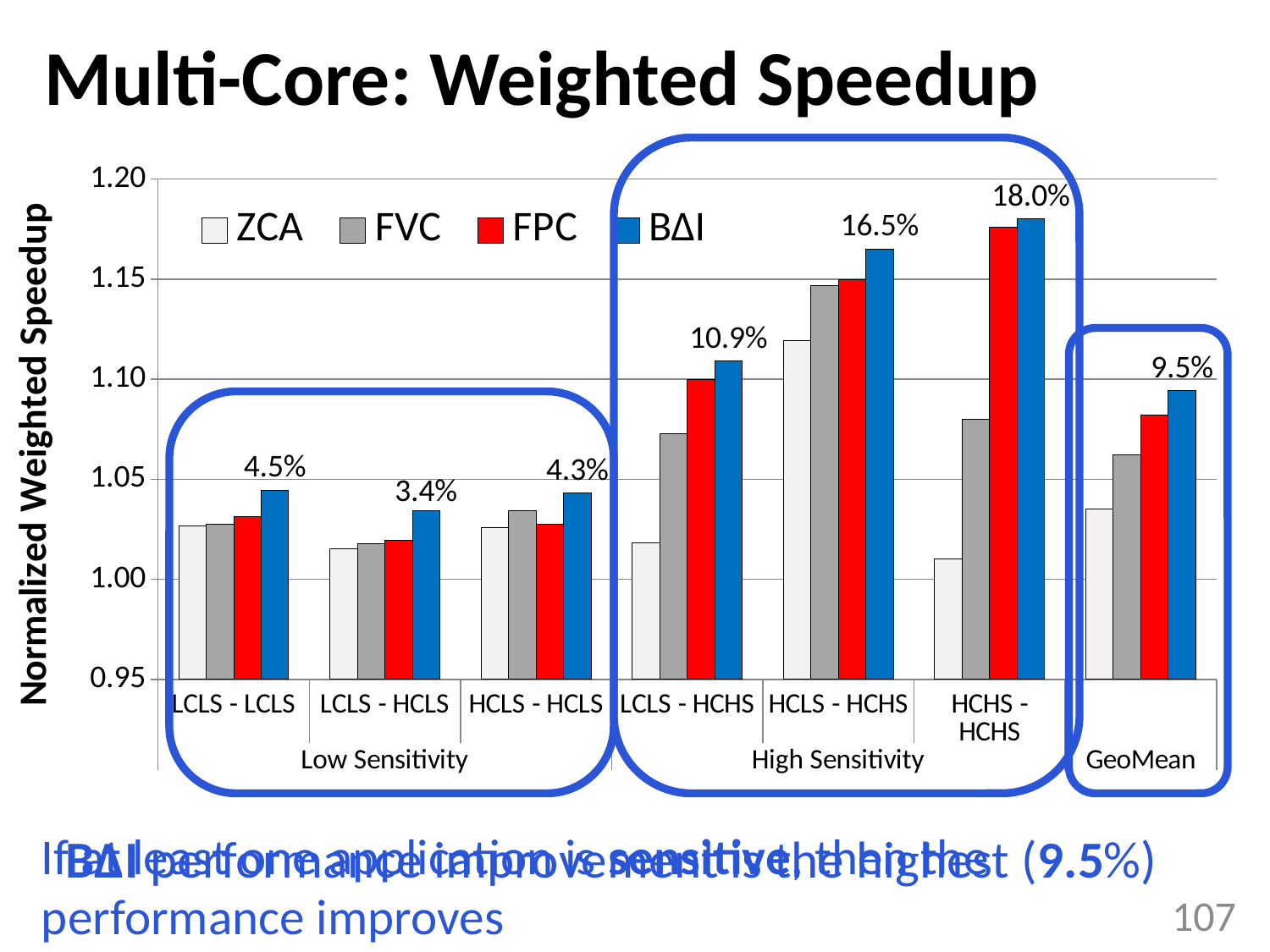
What is the title of the slide containing the chart? Multi-Core: Weighted Speedup Is the BΔI value for HCHS - HCHS greater or less than 1.15? greater How many workload categories are shown along the x axis? 7 How many series does the legend list? 4 Which category has the highest BΔI bar? HCHS - HCHS Which category has the lowest BΔI bar? LCLS - HCLS For HCHS - HCHS, which is larger, the ZCA bar or the FVC bar? FVC What kind of chart is shown on the slide? bar chart What percentage label is printed above the BΔI bar for HCHS - HCHS? 18.0% What percentage label is printed above the BΔI bar for GeoMean? 9.5% Is the ZCA value for HCHS - HCHS greater or less than 1.05? less What percentage label is printed above the BΔI bar for LCLS - HCLS? 3.4%